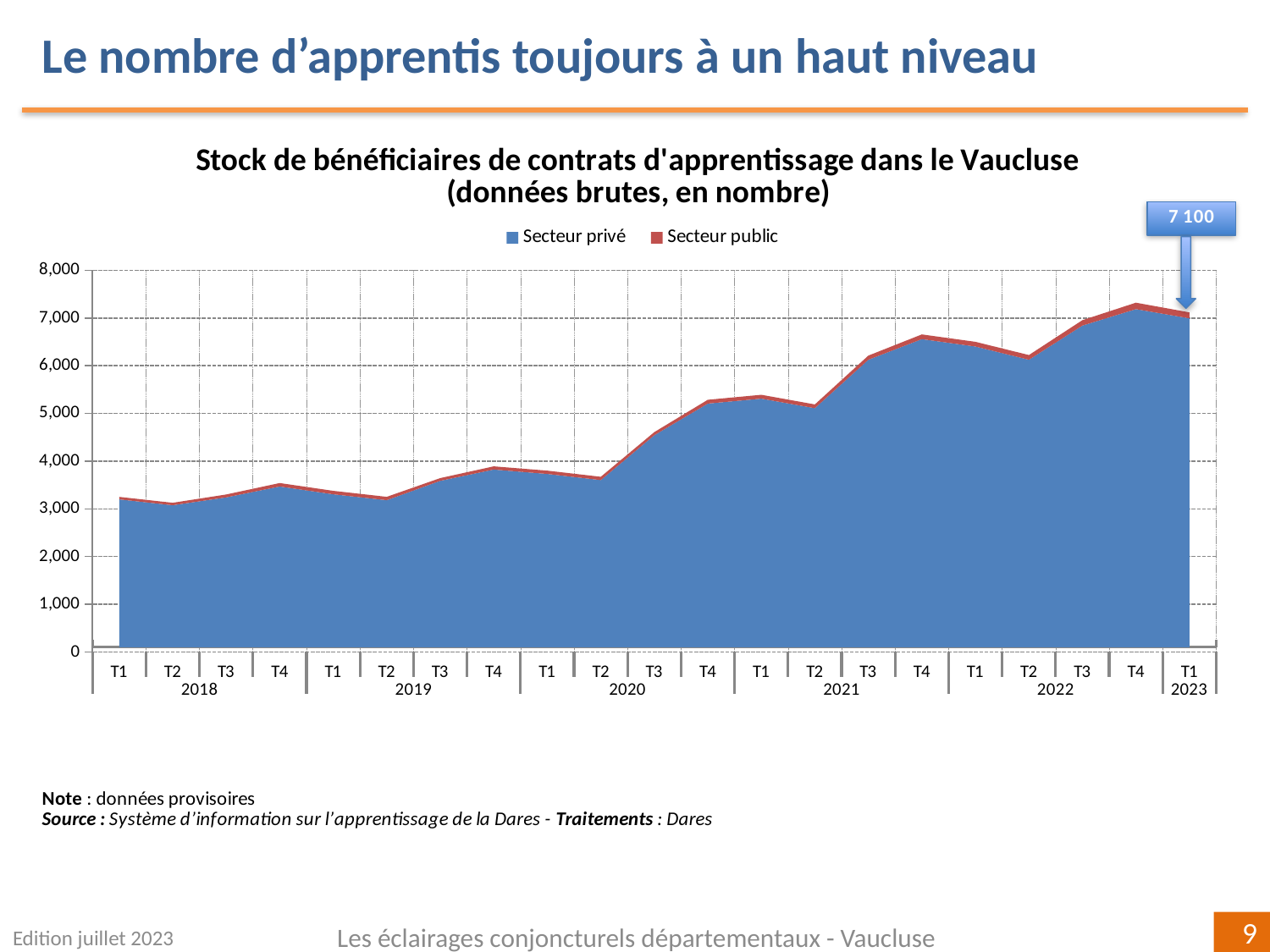
Which is larger, the total for T1 2018 or the total for T1 2023? T1 2023 What total value is indicated by the callout for T1 2023? 7 100 Is the total value for T2 2020 greater or less than 4,000? less How many series does the legend list? 2 Is the total value for T4 2022 greater or less than 7,000? greater What kind of chart is shown on the slide? area chart How many quarterly points are plotted along the x axis? 21 Which series accounts for the larger share of the stacked area, Secteur privé or Secteur public? Secteur privé What are the two series named in the legend? Secteur privé and Secteur public Overall, do the values rise or fall from T1 2018 to T1 2023? rise Is the total value for T4 2021 greater or less than 6,000? greater